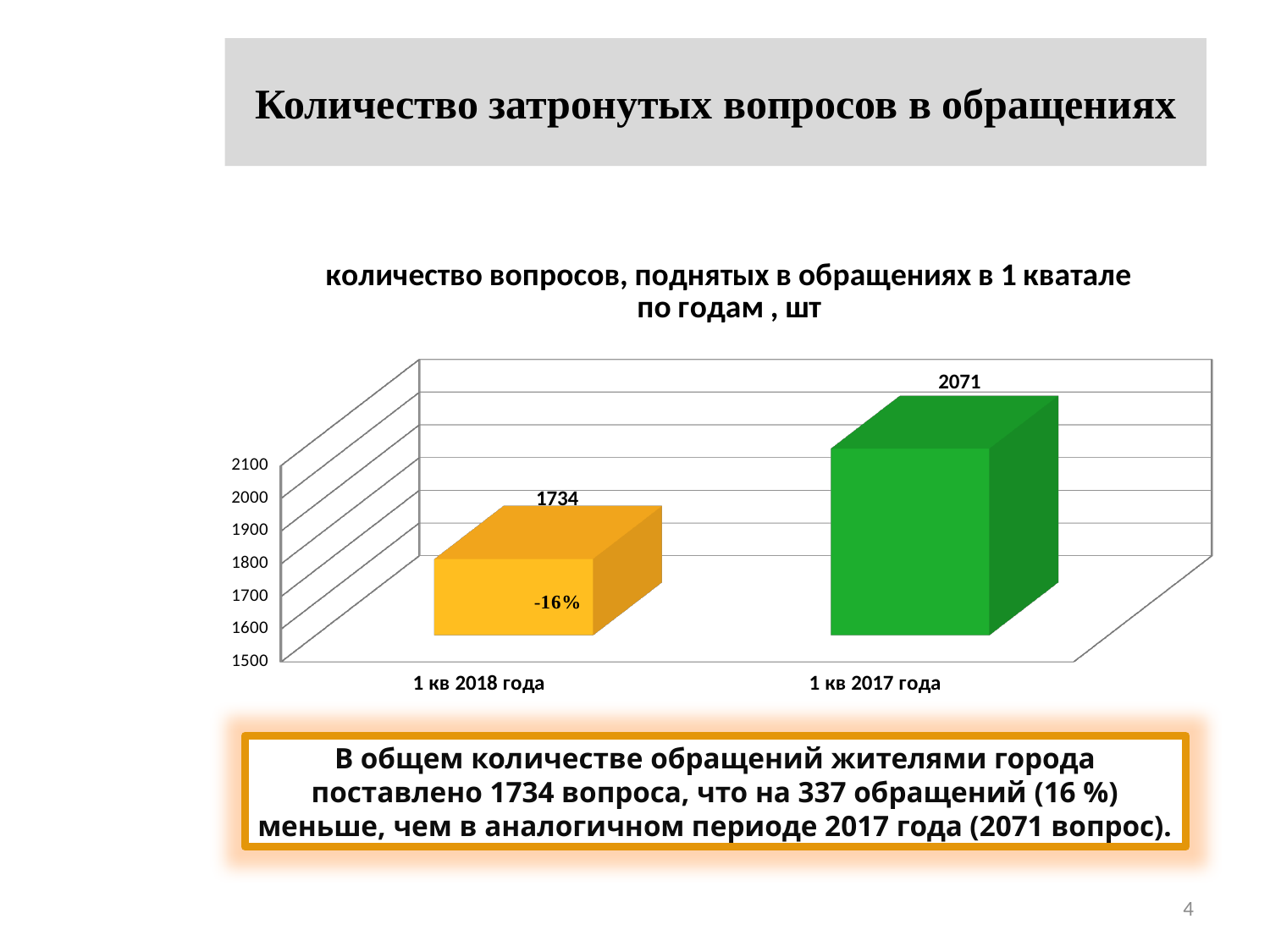
Which is larger, the value for 1 кв 2018 года or the value for 1 кв 2017 года? 1 кв 2017 года What percentage change label is printed on the bar for 1 кв 2018 года? -16% What kind of chart is shown on the slide? bar chart What is the value for 1 кв 2018 года? 1734 Do the values rise or fall from left to right along the x axis? rise Is the value for 1 кв 2018 года greater or less than 1800? less What is the difference between the values for 1 кв 2017 года and 1 кв 2018 года? 337 Which category has the highest value? 1 кв 2017 года What is the value for 1 кв 2017 года? 2071 Which category has the lowest value? 1 кв 2018 года How many categories are shown on the x axis? 2 Is the value for 1 кв 2017 года greater or less than 2000? greater